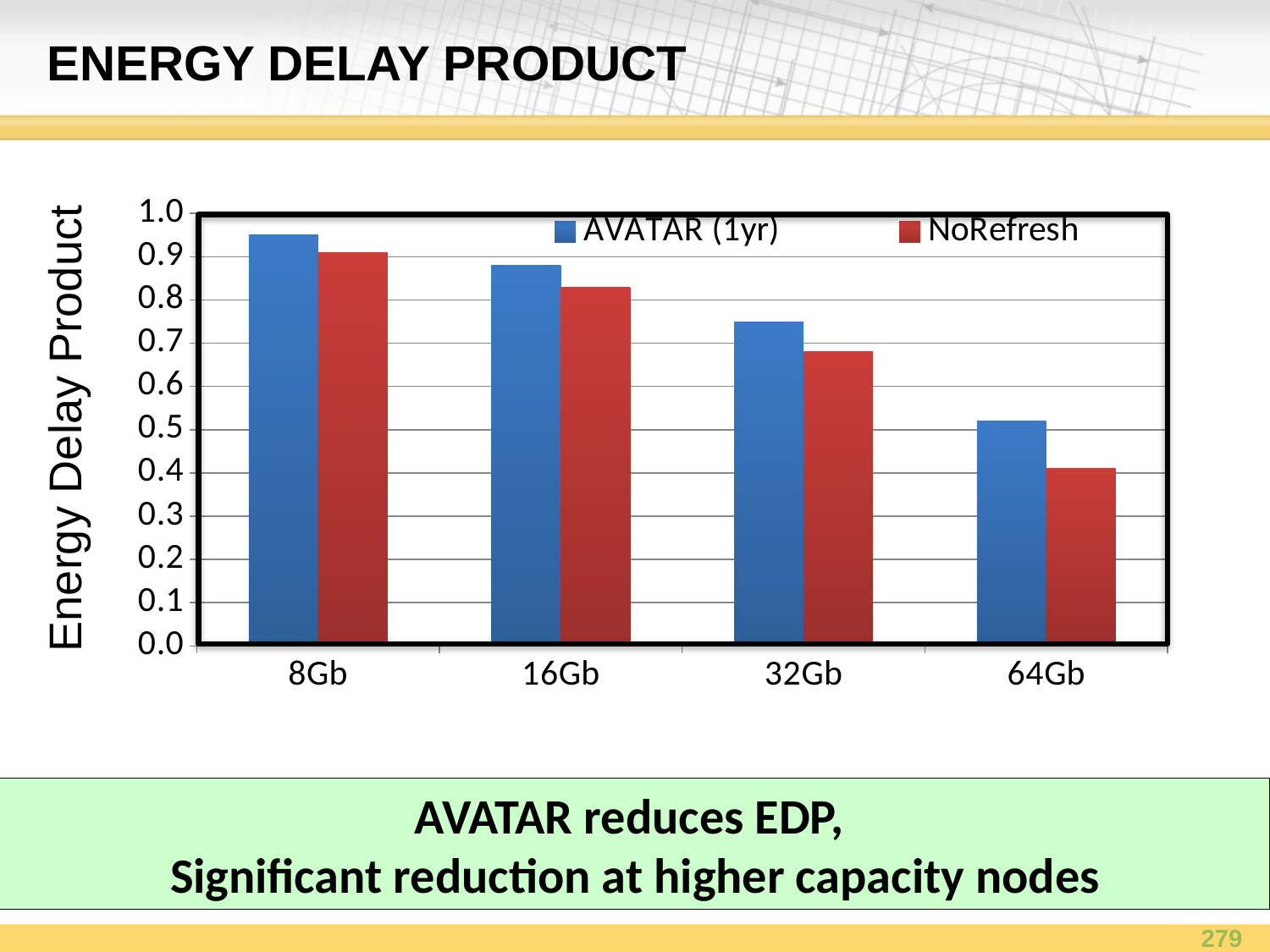
How many series does the legend list? 2 Is the AVATAR (1yr) value for 8Gb greater or less than 0.9? greater Is the NoRefresh value for 64Gb greater or less than 0.5? less How many capacity categories are shown on the x axis? 4 Is the AVATAR (1yr) value for 32Gb greater or less than 0.7? greater Which category has the lowest NoRefresh value? 64Gb Do the NoRefresh values rise or fall as capacity increases from 8Gb to 64Gb? fall What is the label on the vertical axis of the chart? Energy Delay Product What kind of chart is shown on the slide? bar chart At 64Gb, which is larger: AVATAR (1yr) or NoRefresh? AVATAR (1yr) At 32Gb, which is larger: AVATAR (1yr) or NoRefresh? AVATAR (1yr) Which category has the highest AVATAR (1yr) value? 8Gb